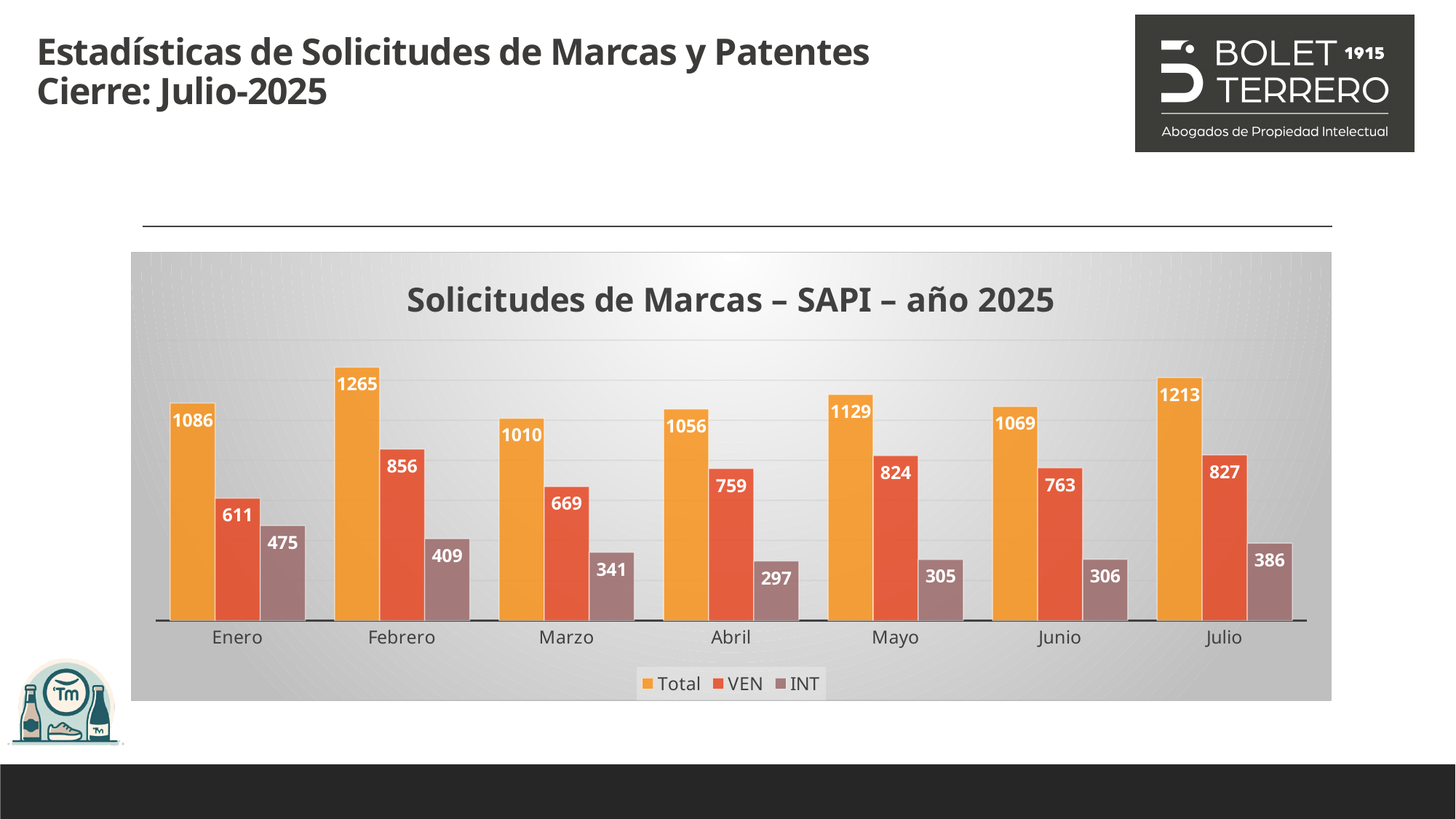
Which series is shown in orange (the tallest bars)? Total How many months are shown on the x axis? 7 What is the VEN value for Abril? 759 What is the Total value for Febrero? 1265 Which month has the lowest INT value? Abril What is the INT value for Julio? 386 What is the difference between the Total values for Julio and Enero? 127 Which is larger, the VEN value for Mayo or the VEN value for Junio? Mayo What is the title of the chart? Solicitudes de Marcas – SAPI – año 2025 How many series does the legend list? 3 What kind of chart is shown on the slide? Bar chart Which month has the highest Total value? Febrero